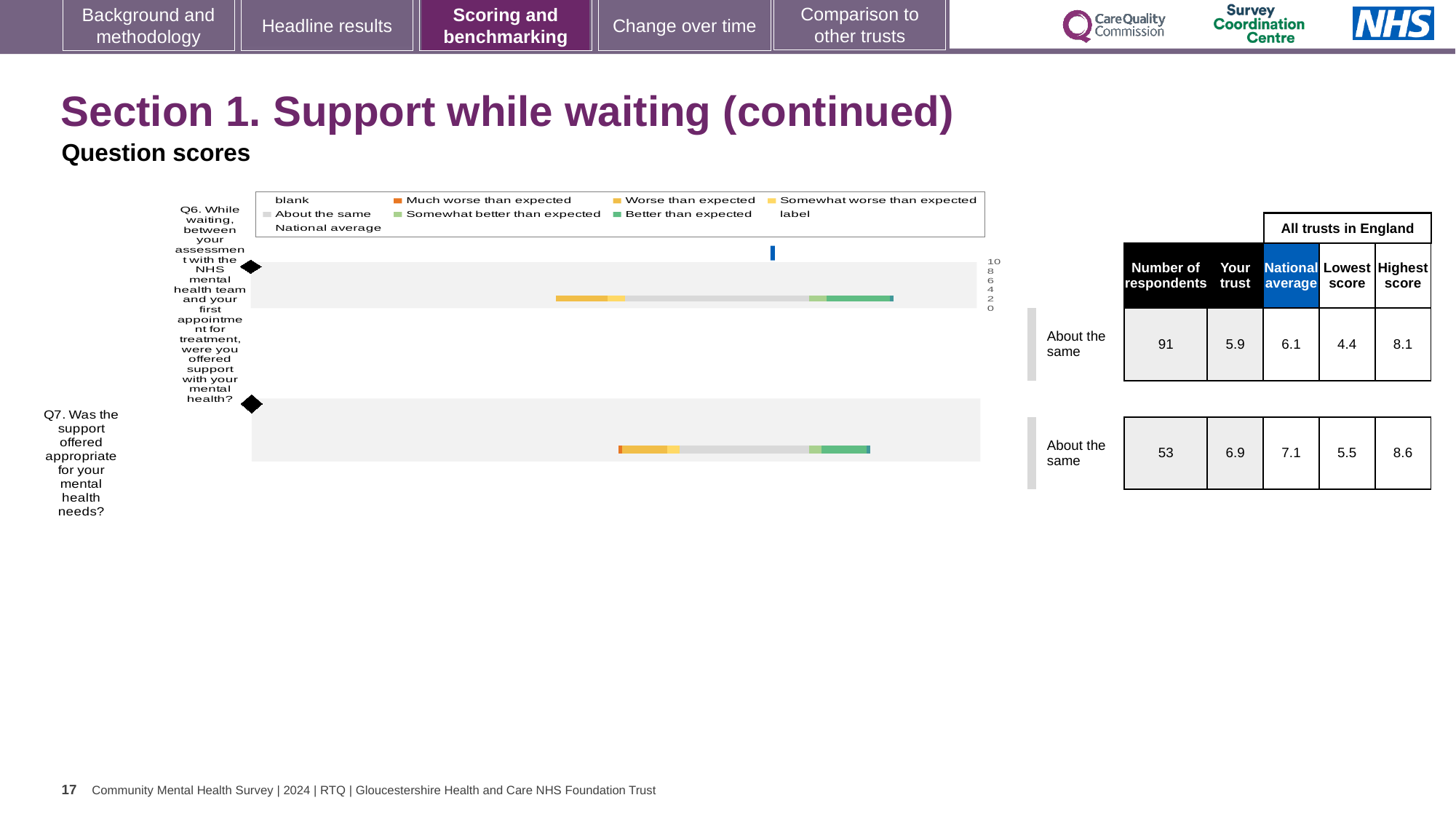
By how much does the national average exceed the trust's score for Q6? 0.2 What is the highest score among all trusts in England for Q7? 8.6 What kind of chart is used to show the question scores on this slide? Bar chart How many respondents answered Q6? 91 What benchmark category is the trust's score for Q7 placed in? About the same For Q6, which is larger: the trust's score or the national average? National average What is the lowest score among all trusts in England for Q7? 5.5 What is the difference between the highest and lowest scores for Q7? 3.1 Which question has the higher 'Your trust' score, Q6 or Q7? Q7 What is the national average score for Q7? 7.1 What is the 'Your trust' score for Q6? 5.9 How many questions are plotted in the chart? 2